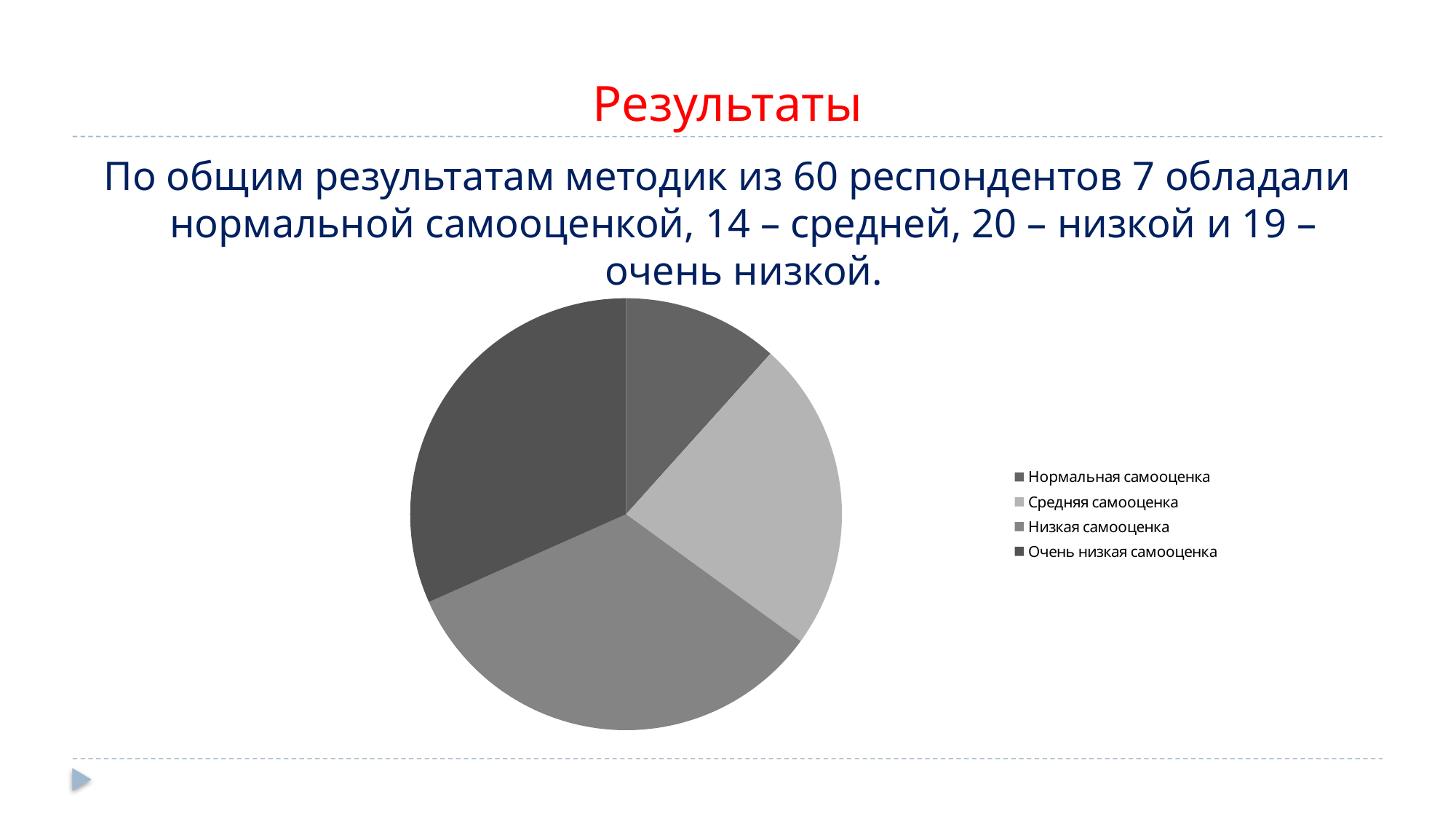
What kind of chart is shown on the slide? pie chart According to the slide, how many respondents had Нормальная самооценка? 7 How many slices does the pie chart have? 4 Which slice is larger: Низкая самооценка or Средняя самооценка? Низкая самооценка How many entries does the legend of the pie chart list? 4 Which slice is larger: Средняя самооценка or Нормальная самооценка? Средняя самооценка According to the slide, how many respondents had Очень низкая самооценка? 19 According to the slide, how many respondents had Низкая самооценка? 20 What is the title of the slide containing the pie chart? Результаты Which category has the smallest slice in the pie chart? Нормальная самооценка According to the slide, how many respondents had Средняя самооценка? 14 What is the total number of respondents represented in the pie chart? 60